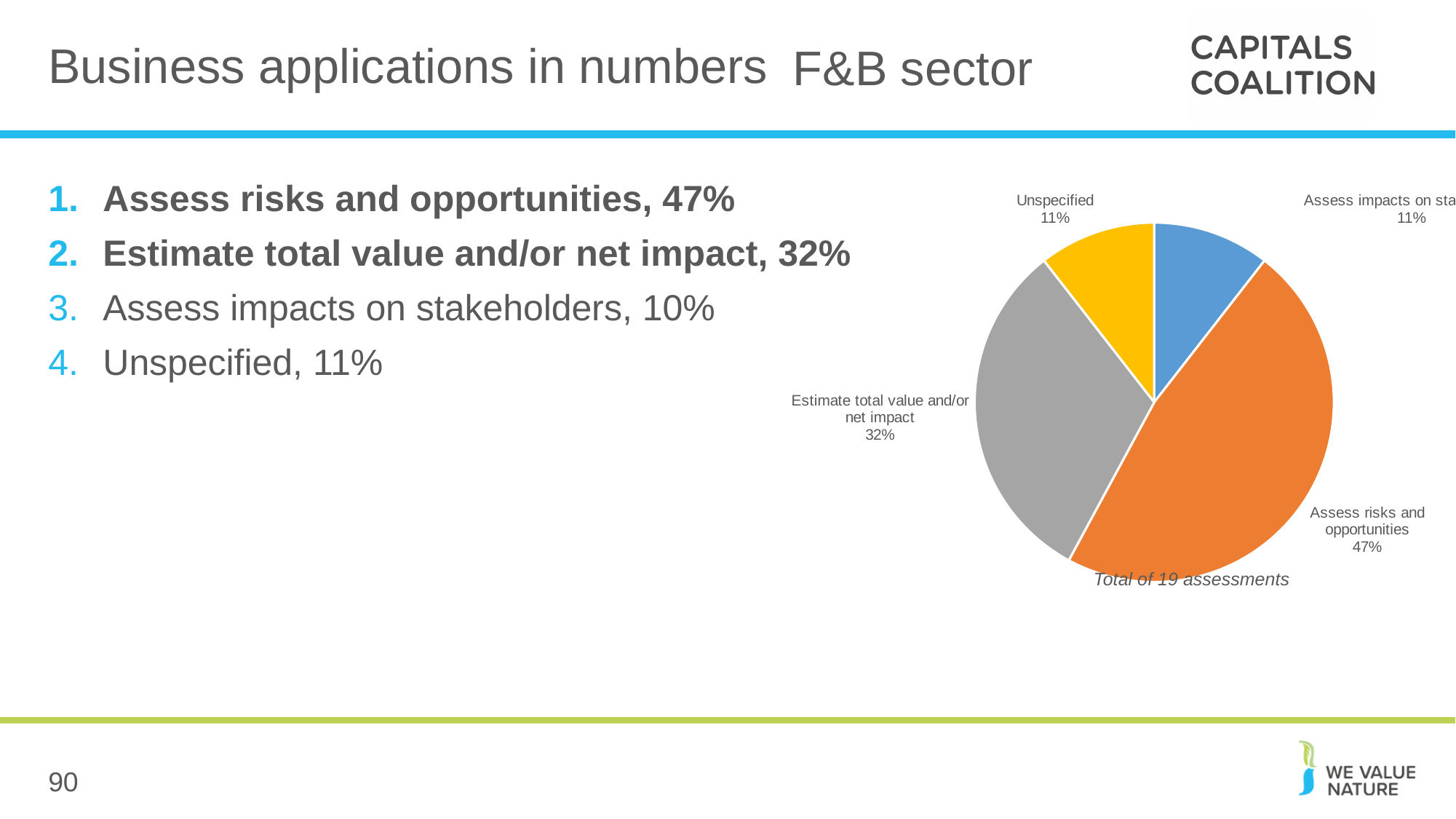
Which slice is larger in the pie chart: 'Estimate total value and/or net impact' or 'Unspecified'? Estimate total value and/or net impact What kind of chart is shown on the slide? pie chart How many percentage points larger is 'Assess risks and opportunities' than 'Estimate total value and/or net impact' in the pie chart? 15 percentage points Which slice of the pie chart is the largest? Assess risks and opportunities What colour is the 'Assess risks and opportunities' slice in the pie chart? orange How many slices does the pie chart have? 4 What percentage does the pie chart show for 'Estimate total value and/or net impact'? 32% Which slice is larger in the pie chart: 'Assess risks and opportunities' or 'Estimate total value and/or net impact'? Assess risks and opportunities According to the note below the pie chart, how many assessments does the chart cover in total? 19 assessments How many percentage points larger is 'Estimate total value and/or net impact' than 'Unspecified' in the pie chart? 21 percentage points What percentage of the pie chart is 'Assess risks and opportunities'? 47% What percentage does the pie chart show for 'Unspecified'? 11%